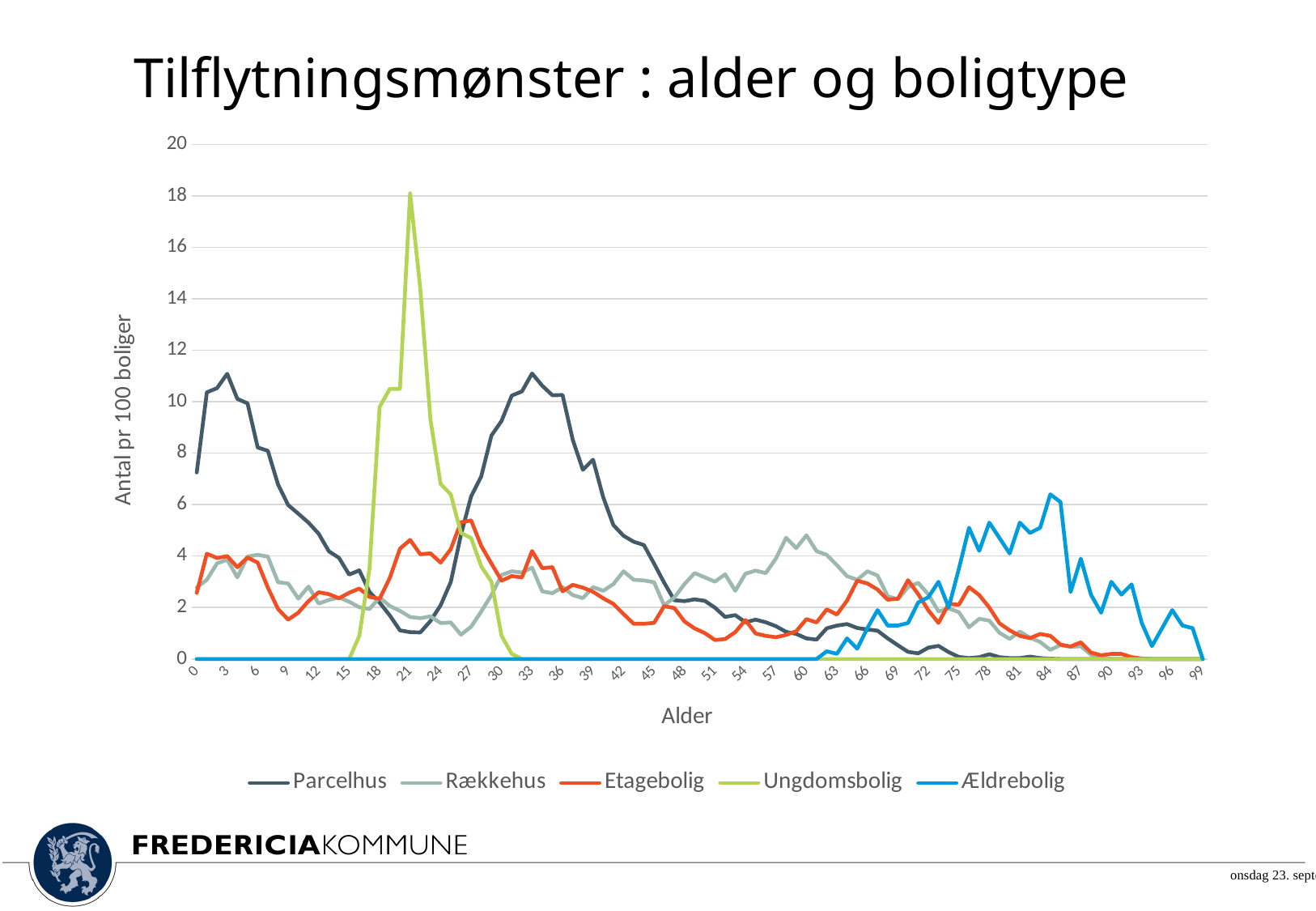
What is the label on the vertical axis? Antal pr 100 boliger What kind of chart is shown on the slide? line chart Is the value for Ungdomsbolig at age 21 greater or less than 16? greater What is the title of the chart? Tilflytningsmønster : alder og boligtype Which series reaches the highest value anywhere on the chart? Ungdomsbolig Does the Ældrebolig line rise or fall between age 63 and age 84? rise Is the value for Parcelhus at age 3 greater or less than 10? greater Does the Parcelhus line rise or fall between age 36 and age 60? fall Is the value for Ældrebolig at age 84 greater or less than 4? greater How many series does the legend list? 5 At age 21, which series has the larger value, Ungdomsbolig or Etagebolig? Ungdomsbolig